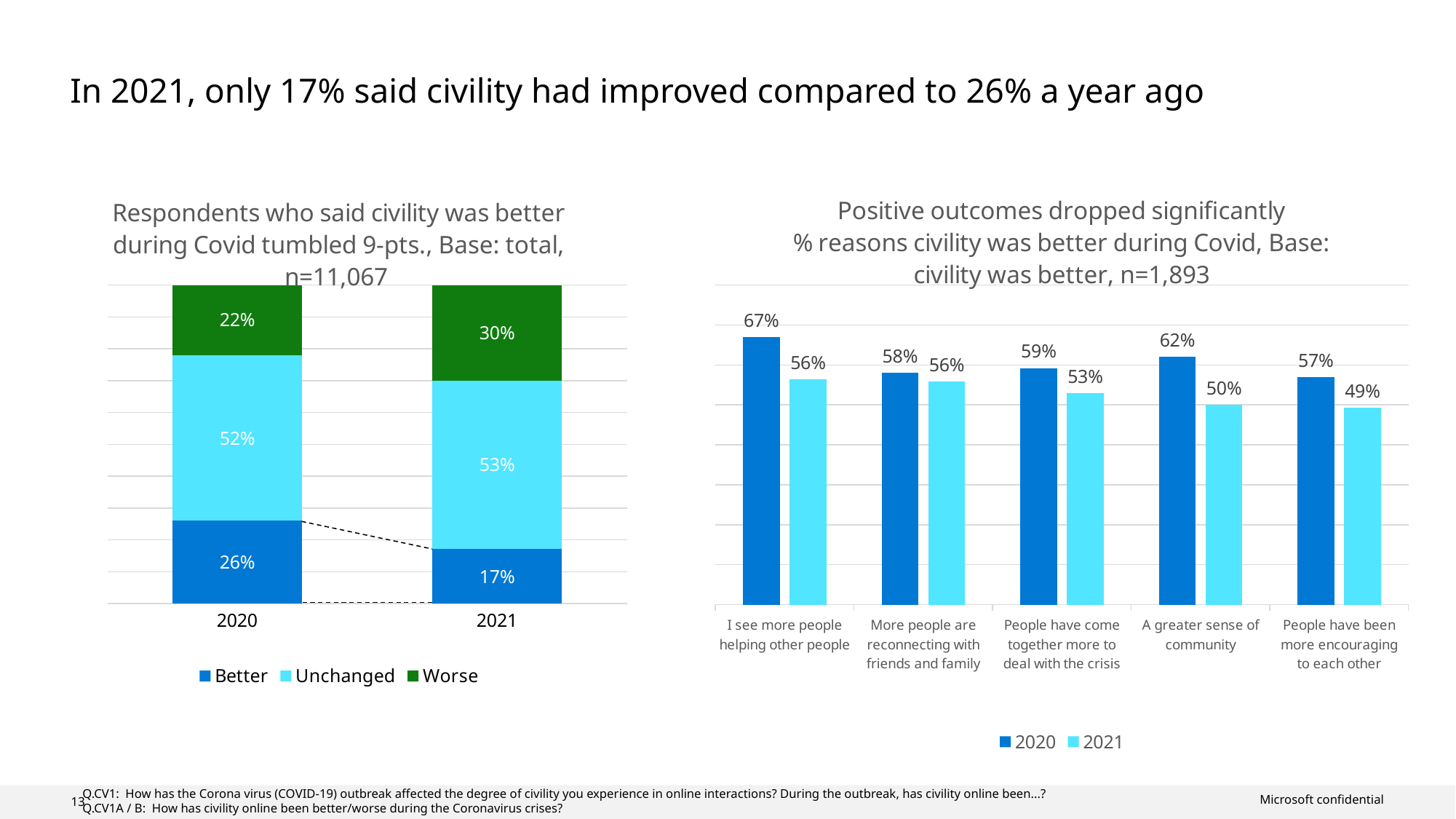
In the right chart, how many categories are shown on the x axis? 5 In the left chart, which year has the larger Worse share, 2020 or 2021? 2021 What kind of chart is the right chart? Bar chart In the left chart, what is the total of the stacked bar for 2020? 100% In the left chart, how many series does the legend list? 3 In the left chart, what percentage said civility was Worse in 2020? 22% In the left chart (Respondents who said civility was better during Covid tumbled 9-pts.), what percentage said civility was Better in 2021? 17% In the right chart (Positive outcomes dropped significantly), what is the 2020 value for 'A greater sense of community'? 62% In the left chart, what is the difference between the Unchanged share in 2021 and in 2020? 1% In the right chart, which category has the highest 2020 value? I see more people helping other people In the right chart, which category has the lowest 2021 value? People have been more encouraging to each other In the right chart, what is the difference between the 2020 and 2021 values for 'I see more people helping other people'? 11%